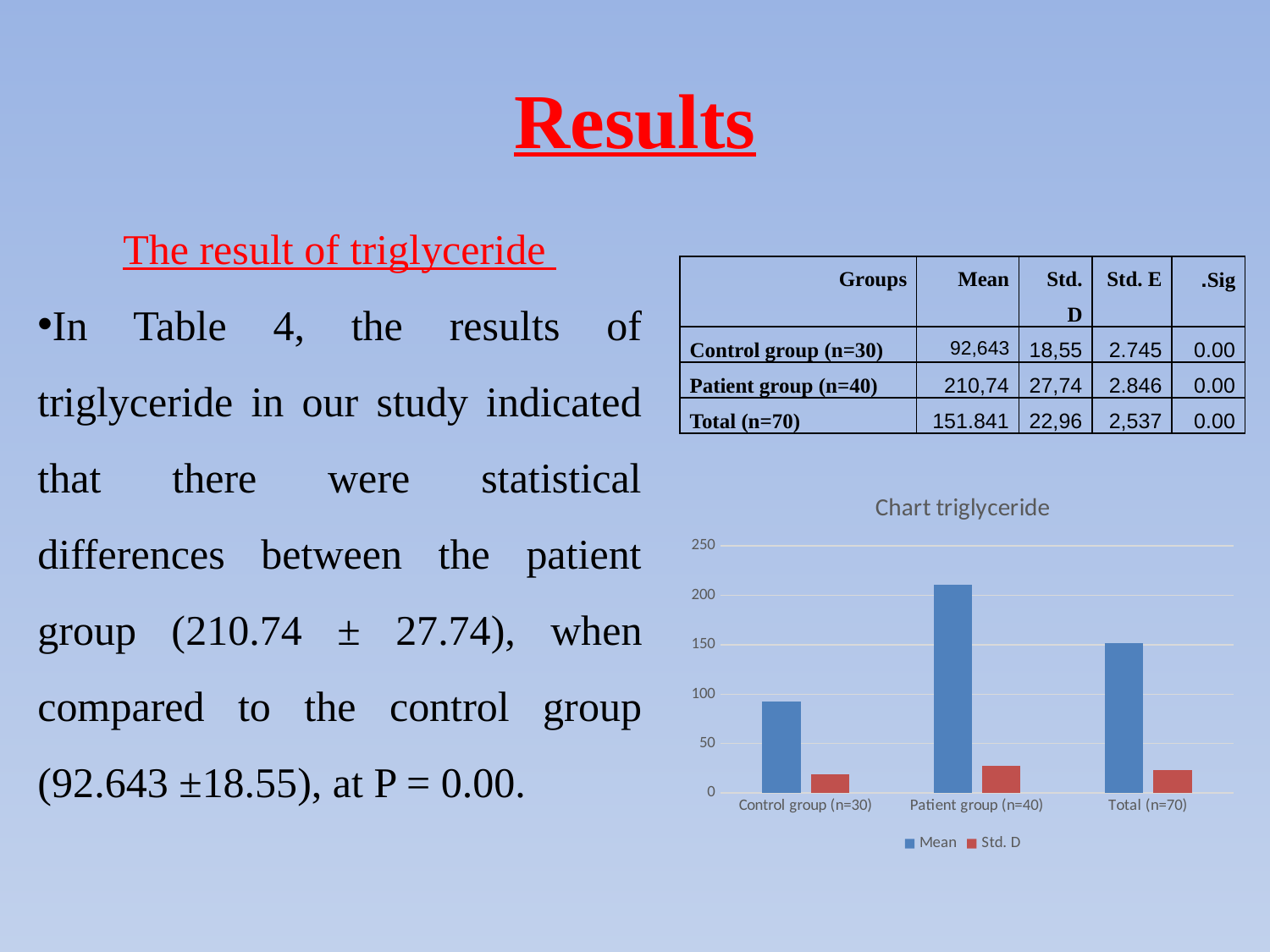
Which group has the lowest Mean bar in the chart? Control group (n=30) What kind of chart is shown on the slide? bar chart Is the Mean value for Patient group (n=40) greater or less than 200? greater What is the title of the chart? Chart triglyceride Which is larger in the chart: the Mean bar for Total (n=70) or the Mean bar for Control group (n=30)? Total (n=70) Is the Std. D value for Patient group (n=40) greater or less than 50? less Which series is shown in blue in the chart? Mean How many series does the chart legend list? 2 How many groups are shown on the x axis of the chart? 3 Is the Mean value for Control group (n=30) greater or less than 100? less Which group has the highest Mean bar in the chart? Patient group (n=40)